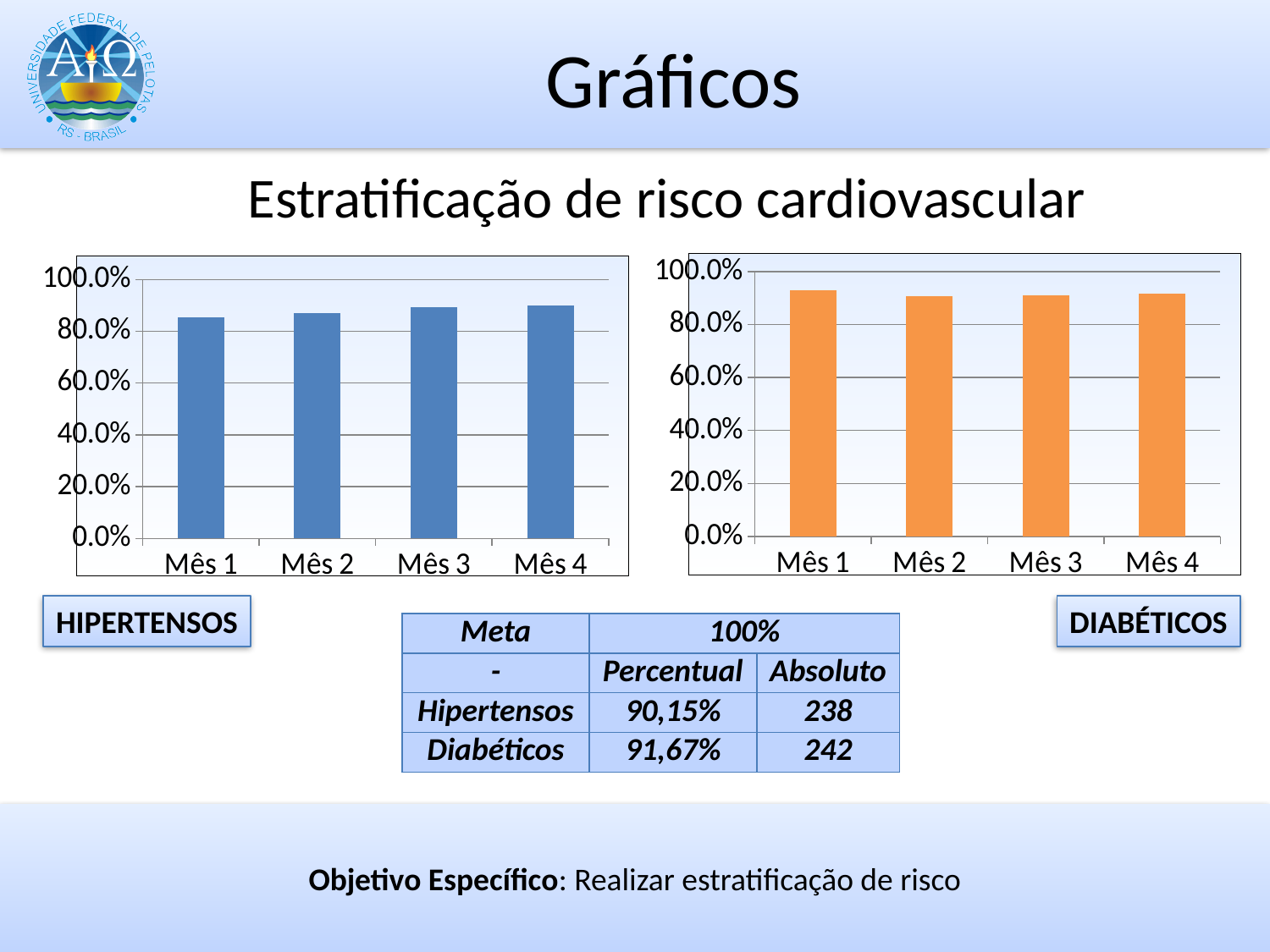
In the right chart (DIABÉTICOS), is the value for Mês 1 greater or less than 100.0%? less In the left chart (HIPERTENSOS), which is larger, the value for Mês 1 or the value for Mês 4? Mês 4 What kind of chart is the right chart (DIABÉTICOS)? Bar chart What colour are the bars in the right chart (DIABÉTICOS)? Orange In the left chart (HIPERTENSOS), which month has the lowest value? Mês 1 What kind of chart is the left chart (HIPERTENSOS)? Bar chart In the left chart (HIPERTENSOS), is the value for Mês 4 greater or less than 100.0%? less In the left chart (HIPERTENSOS), is the value for Mês 1 greater or less than 80.0%? greater How many bars are plotted in the right chart (DIABÉTICOS)? 4 How many categories are shown on the x axis of the left chart (HIPERTENSOS)? 4 In the left chart (HIPERTENSOS), do the values rise or fall from Mês 1 to Mês 4? Rise